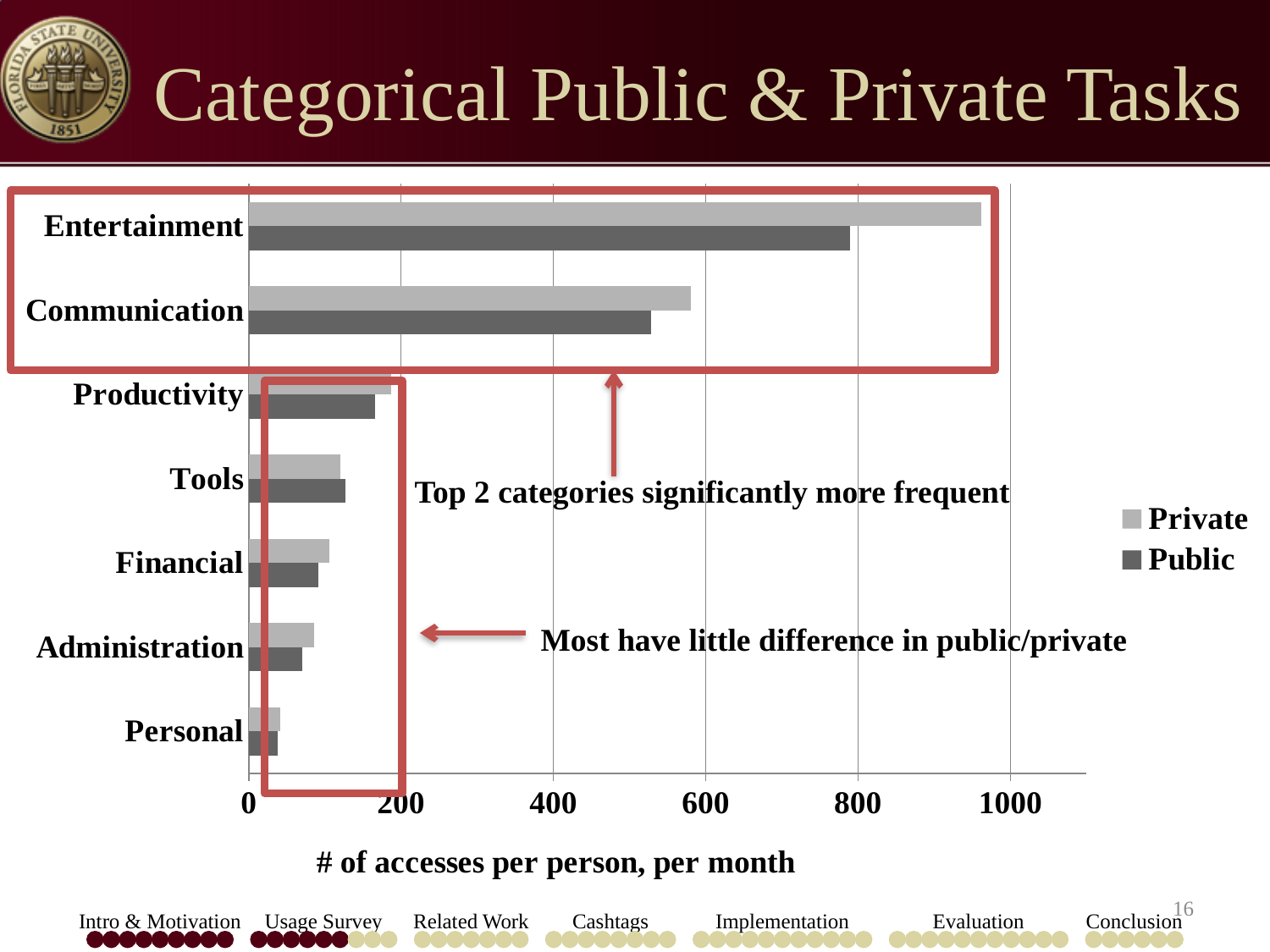
Which category has the lowest Public value? Personal What is the title of the horizontal axis? # of accesses per person, per month For Entertainment, which is larger: the Private value or the Public value? Private Is the Public value for Communication greater or less than 400? greater Which is larger: the Private value for Communication or the Private value for Productivity? Communication How many series does the legend list? 2 Is the Public value for Entertainment greater or less than 600? greater Is the Private value for Tools greater or less than 200? less What kind of chart is shown on the slide? bar chart Which category has the highest Private value? Entertainment How many task categories are plotted on the chart? 7